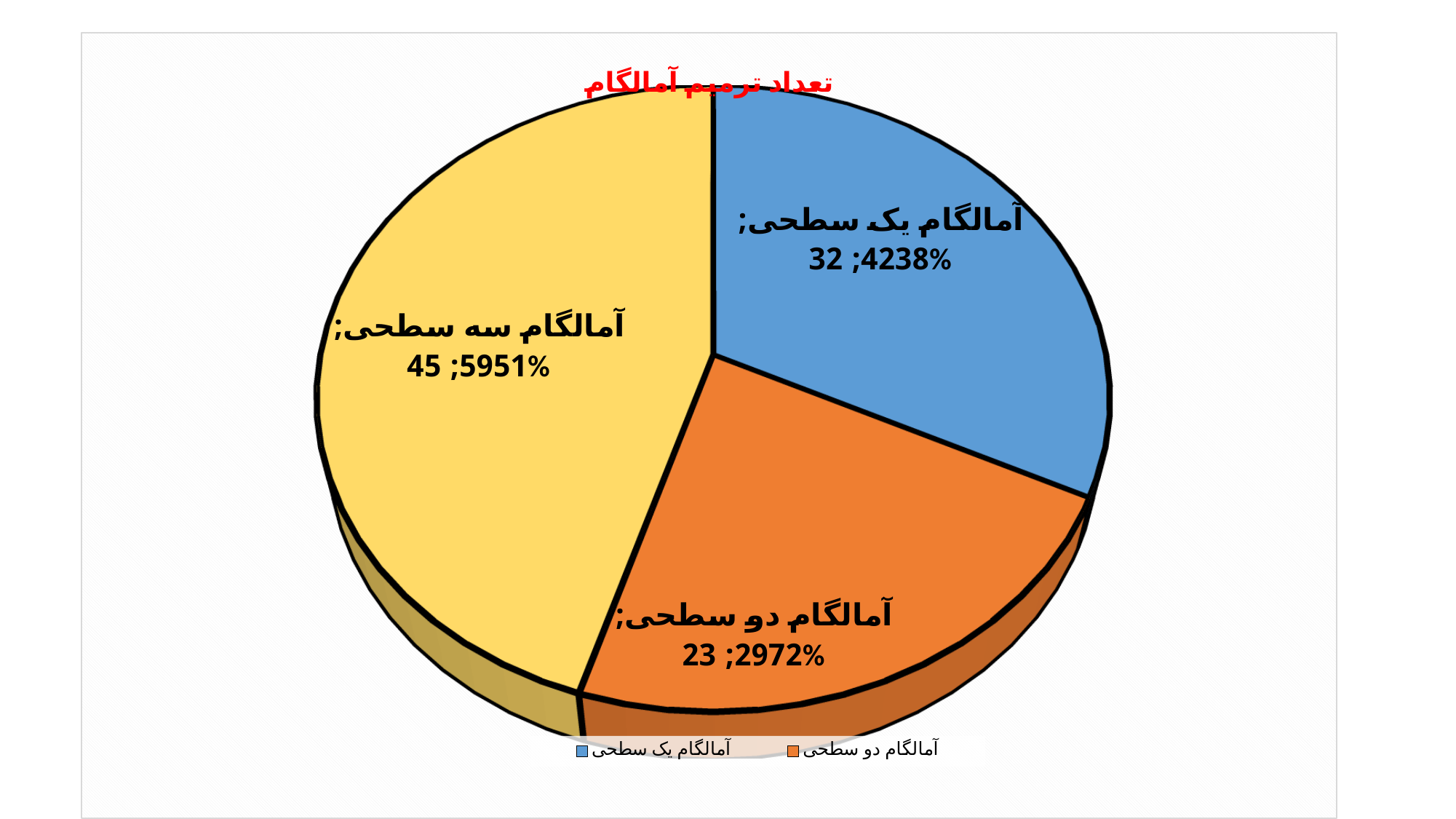
Which category has the smallest slice of the pie? آمالگام دو سطحی What colour is the slice for آمالگام سه سطحی? Yellow Which is larger, the value for آمالگام یک سطحی or آمالگام دو سطحی? آمالگام یک سطحی How many slices does the pie chart have? 3 What is the value shown for آمالگام دو سطحی? 2972 What is the total of the three values shown on the pie chart? 13161 Which category has the largest slice of the pie? آمالگام سه سطحی What type of chart is shown on the slide? Pie chart What is the value shown for آمالگام سه سطحی? 5951 What is the value shown for آمالگام یک سطحی? 4238 What is the difference between the values for آمالگام سه سطحی and آمالگام دو سطحی? 2979 What is the title of the chart? تعداد ترمیم آمالگام